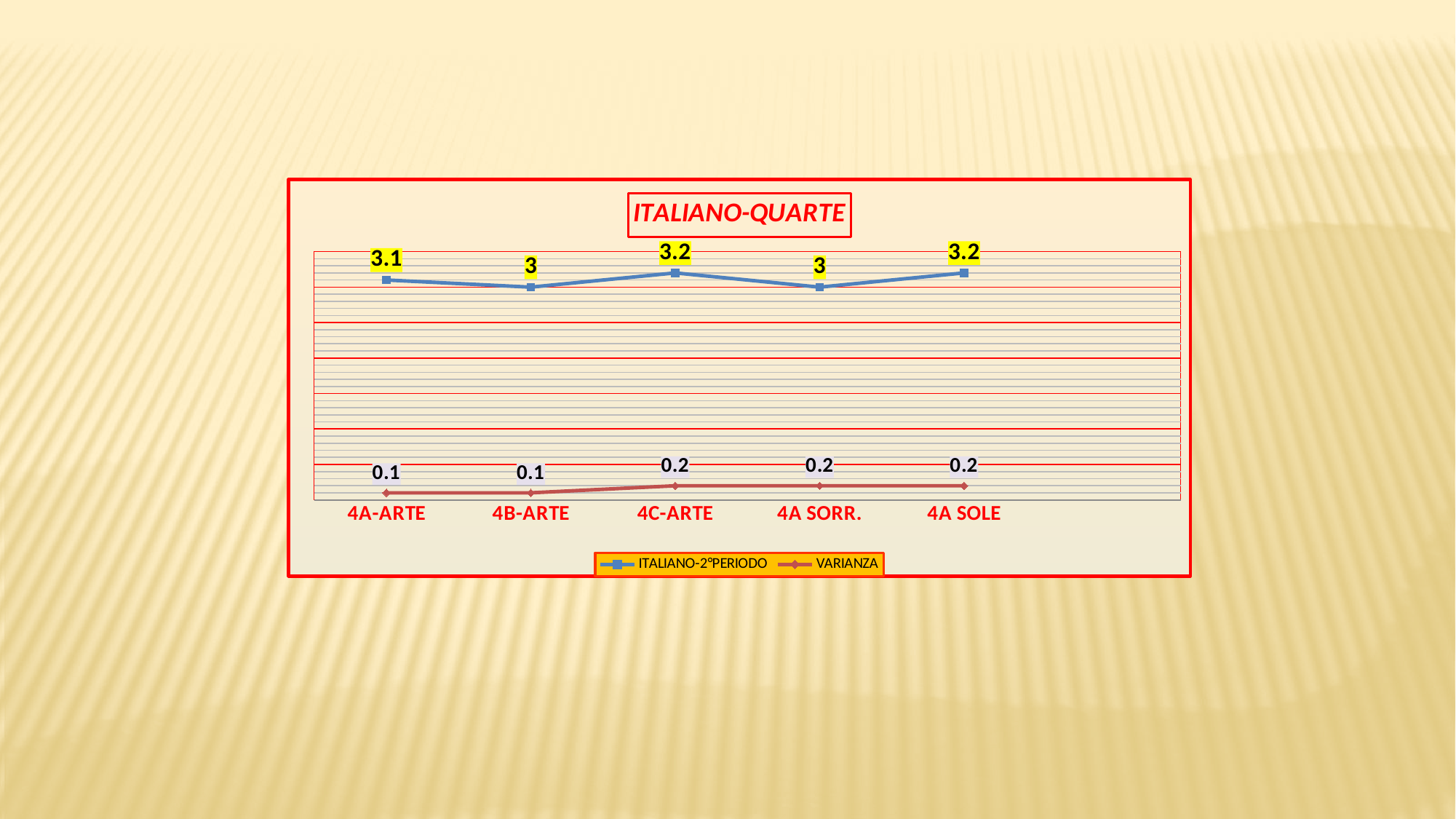
What is the difference between the ITALIANO-2°PERIODO values for 4C-ARTE and 4B-ARTE? 0.2 How many categories are shown on the x axis? 5 Which series is drawn in blue? ITALIANO-2°PERIODO What is the VARIANZA value for 4C-ARTE? 0.2 Which category has the lowest VARIANZA value, 4A-ARTE or 4A SOLE? 4A-ARTE What is the title of the chart? ITALIANO-QUARTE How many series does the legend list? 2 What is the VARIANZA value for 4B-ARTE? 0.1 Is the ITALIANO-2°PERIODO value for 4A SOLE larger than the value for 4A SORR.? Yes What is the ITALIANO-2°PERIODO value for 4A SORR.? 3 What is the ITALIANO-2°PERIODO value for 4A-ARTE? 3.1 What kind of chart is shown on the slide? Line chart